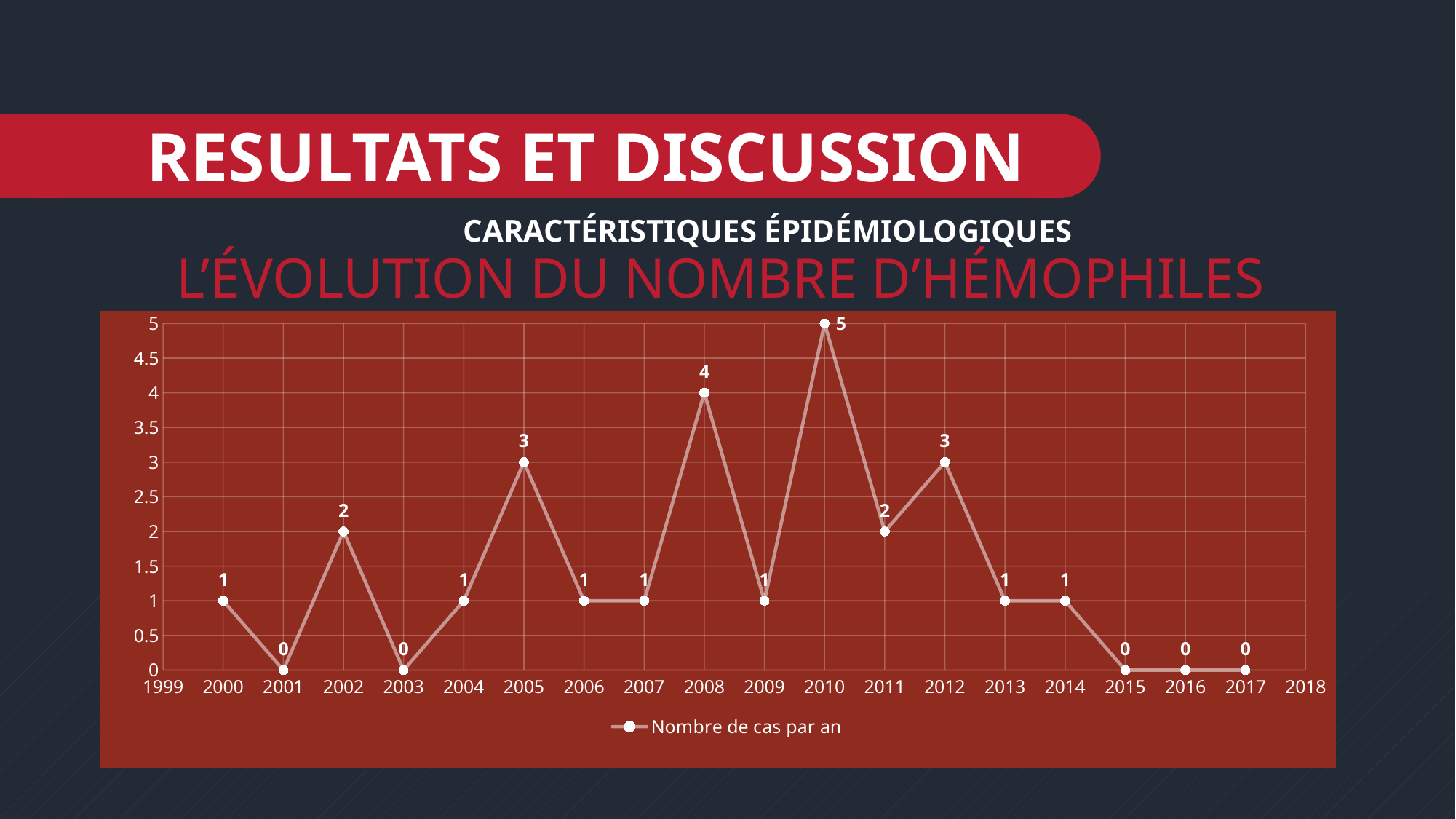
How many data points are plotted on the line? 18 What is the name of the series shown in the legend? Nombre de cas par an Which year has the highest number of cases? 2010 How many series does the legend list? 1 What is the difference between the number of cases in 2010 and in 2008? 1 What is the difference between the number of cases in 2012 and in 2013? 2 What type of chart is shown on the slide? line chart Which year has more cases, 2002 or 2005? 2005 What is the number of cases in 2011? 2 What is the number of cases in 2005? 3 What is the number of cases in 2010? 5 What is the number of cases in 2008? 4